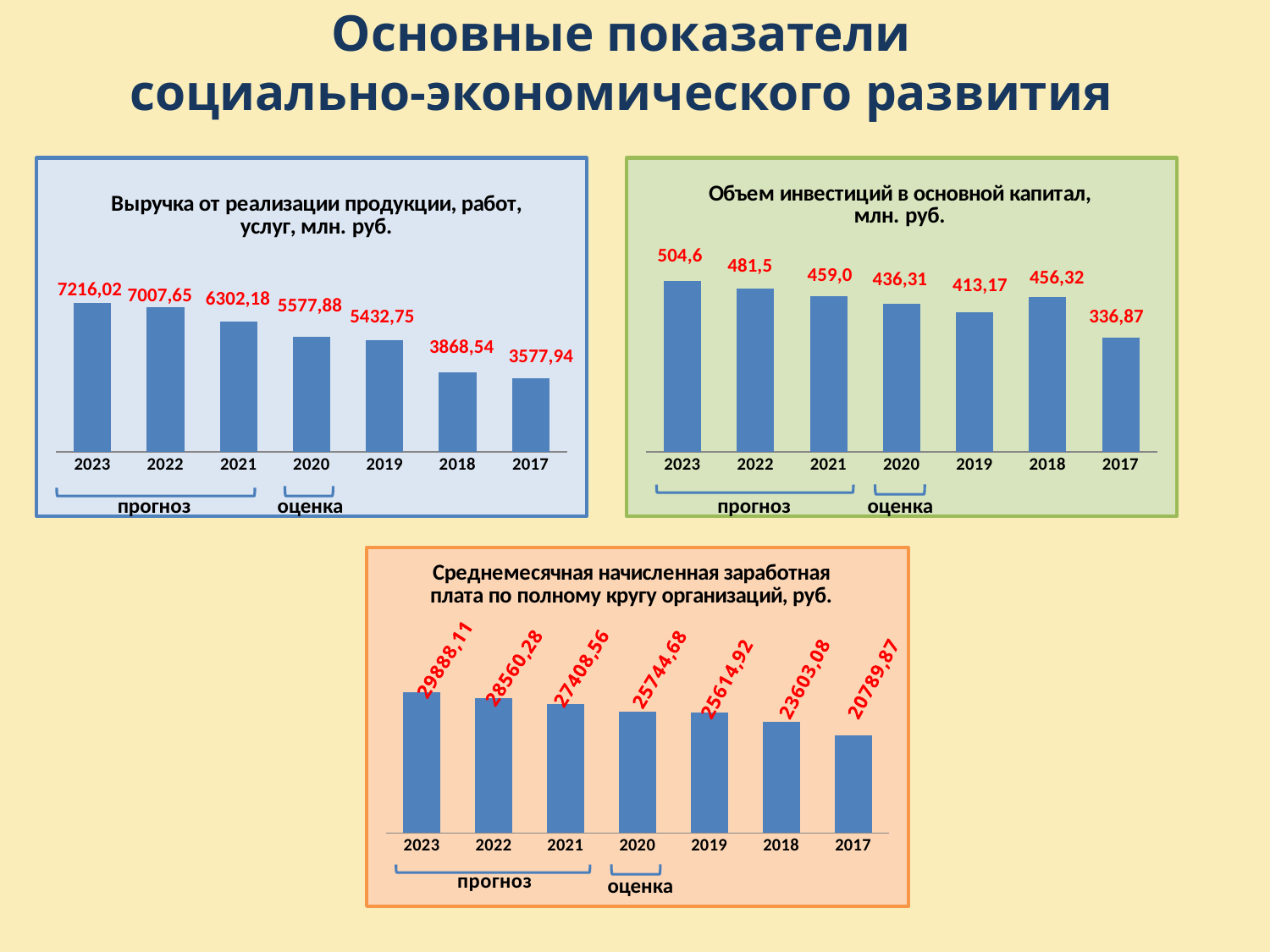
What kind of chart is 'Среднемесячная начисленная заработная плата по полному кругу организаций, руб.'? bar chart In the chart 'Среднемесячная начисленная заработная плата по полному кругу организаций, руб.', what is the difference between the values for 2023 and 2022? 1327,83 In the chart 'Выручка от реализации продукции, работ, услуг, млн. руб.', how many years are plotted? 7 In the chart 'Выручка от реализации продукции, работ, услуг, млн. руб.', what is the value for 2021? 6302,18 In the chart 'Выручка от реализации продукции, работ, услуг, млн. руб.', what is the difference between the values for 2023 and 2017? 3638,08 In the chart 'Выручка от реализации продукции, работ, услуг, млн. руб.', which year has the lowest value? 2017 In the chart 'Объем инвестиций в основной капитал, млн. руб.', what is the difference between the values for 2018 and 2019? 43,15 In the chart 'Среднемесячная начисленная заработная плата по полному кругу организаций, руб.', do the values rise or fall moving left to right along the x axis from 2023 to 2017? fall In the chart 'Среднемесячная начисленная заработная плата по полному кругу организаций, руб.', what is the value for 2020? 25744,68 In the chart 'Объем инвестиций в основной капитал, млн. руб.', which year has the highest value? 2023 In the chart 'Объем инвестиций в основной капитал, млн. руб.', what is the value for 2019? 413,17 In the chart 'Объем инвестиций в основной капитал, млн. руб.', which is larger, the value for 2018 or the value for 2019? 2018